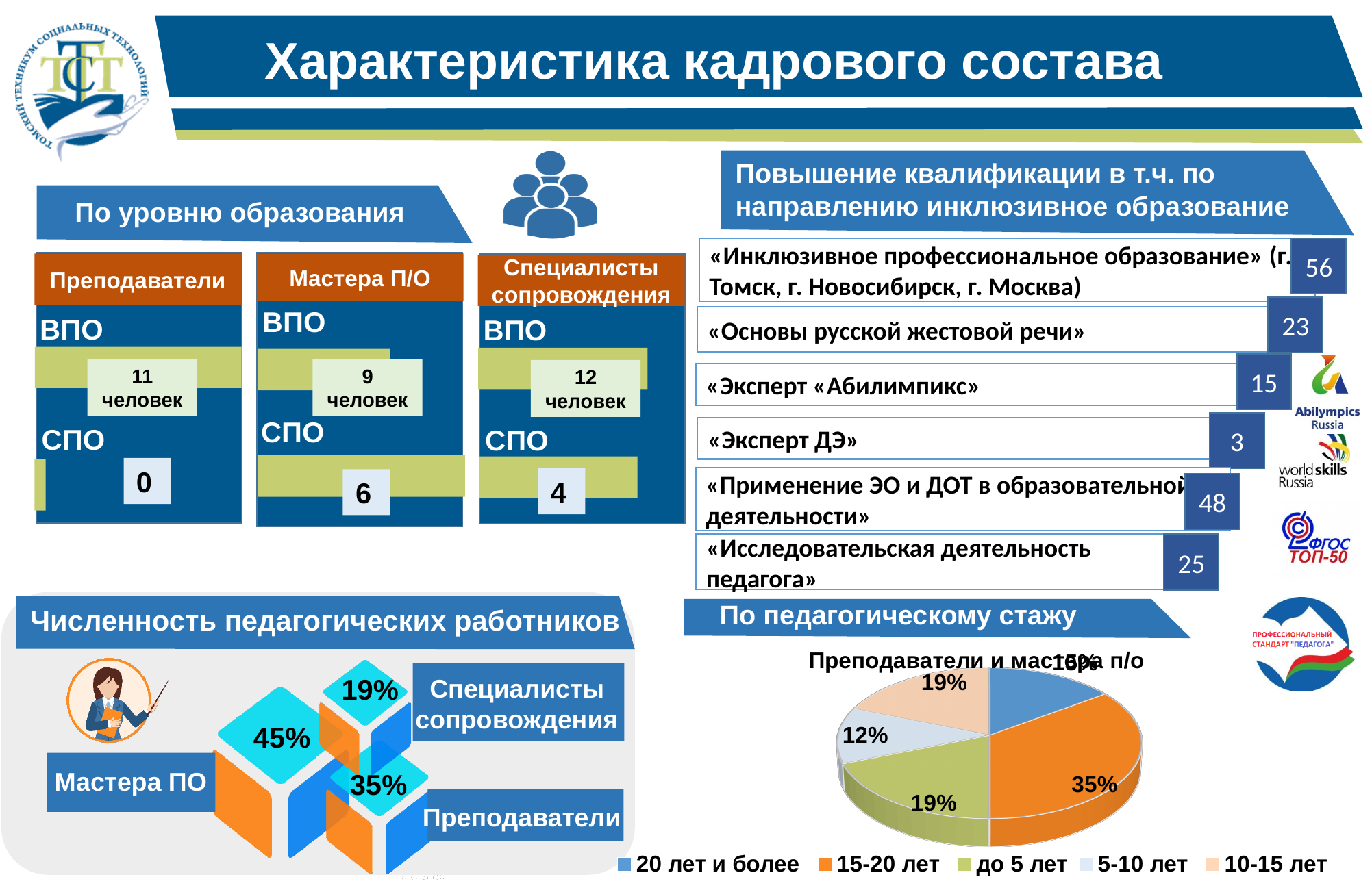
In the pie chart «Преподаватели и мастера п/о», what share is labelled for «до 5 лет»? 19% In the pie chart «Преподаватели и мастера п/о», what share is labelled for «5-10 лет»? 12% In the pie chart «Преподаватели и мастера п/о», which is larger: «15-20 лет» or «до 5 лет»? 15-20 лет What is the title of the pie chart under «По педагогическому стажу»? Преподаватели и мастера п/о In the pie chart «Преподаватели и мастера п/о», what share is labelled for «15-20 лет»? 35% How many entries does the legend of the pie chart «Преподаватели и мастера п/о» list? 5 In the pie chart «Преподаватели и мастера п/о», which is larger: «до 5 лет» or «5-10 лет»? до 5 лет How many slices does the pie chart «Преподаватели и мастера п/о» have? 5 In the pie chart «Преподаватели и мастера п/о», which category has the largest slice? 15-20 лет In the pie chart «Преподаватели и мастера п/о», what is the difference in percentage points between «15-20 лет» and «5-10 лет»? 23 What kind of chart is shown under the heading «По педагогическому стажу»? pie chart In the pie chart «Преподаватели и мастера п/о», what share is labelled for «10-15 лет»? 19%